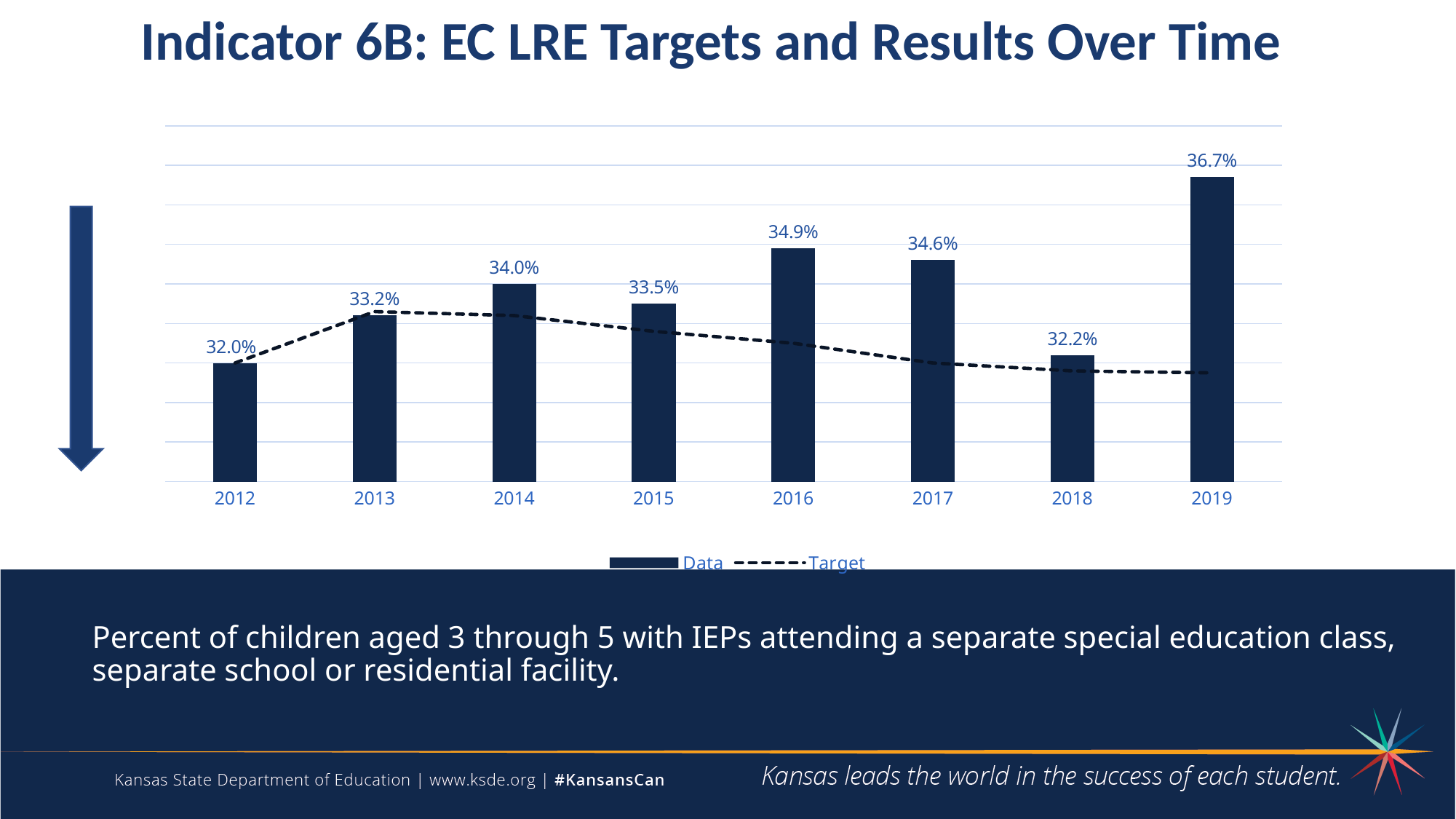
What is the difference between the Data values for 2019 and 2018? 4.5% How many years are shown on the x axis? 8 Which year has the highest Data value? 2019 What is the Data value for 2016? 34.9% How many series does the legend list? 2 What is the Data value for 2012? 32.0% What is the Data value for 2019? 36.7% Which year has the lowest Data value? 2012 What kind of chart is used to show the Data series? Bar chart What is the Data value for 2018? 32.2% Which year has the larger Data value, 2014 or 2015? 2014 What are the two entries in the legend? Data and Target